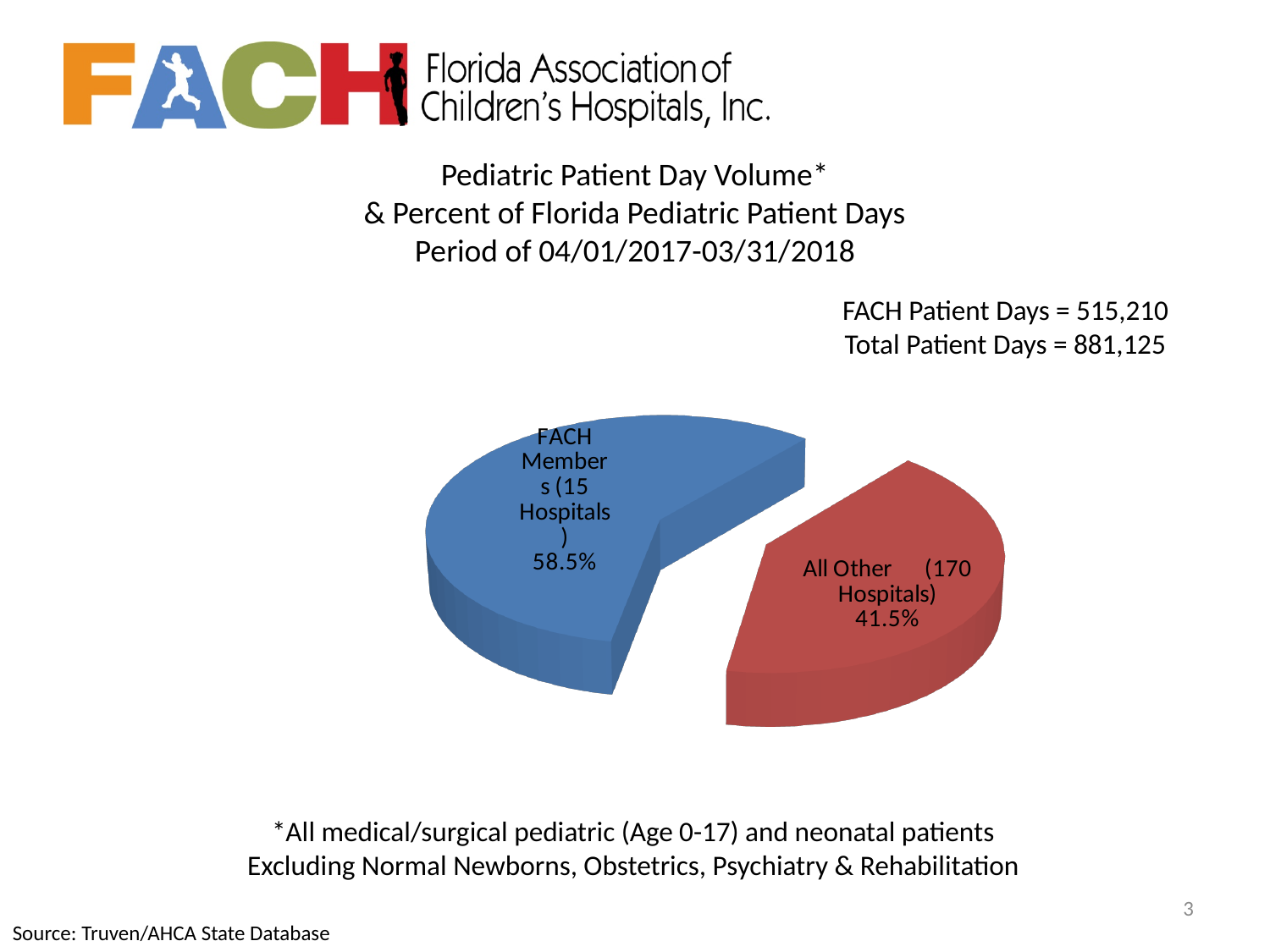
How many hospitals are included in the FACH Members slice? 15 What colour is the FACH Members slice of the pie? Blue How many hospitals are included in the All Other slice? 170 What period does the chart cover, according to its title? 04/01/2017-03/31/2018 How many slices does the pie chart have? 2 Which category has the smallest share of the pie? All Other (170 Hospitals) What share of Florida pediatric patient days is attributed to All Other (170 Hospitals)? 41.5% What kind of chart is shown on the slide? Pie chart Is the share for FACH Members greater or less than 50%? greater What share of Florida pediatric patient days is attributed to FACH Members (15 Hospitals)? 58.5% What is the difference in percentage points between the FACH Members share and the All Other share? 17 percentage points Which slice of the pie is larger, FACH Members or All Other? FACH Members